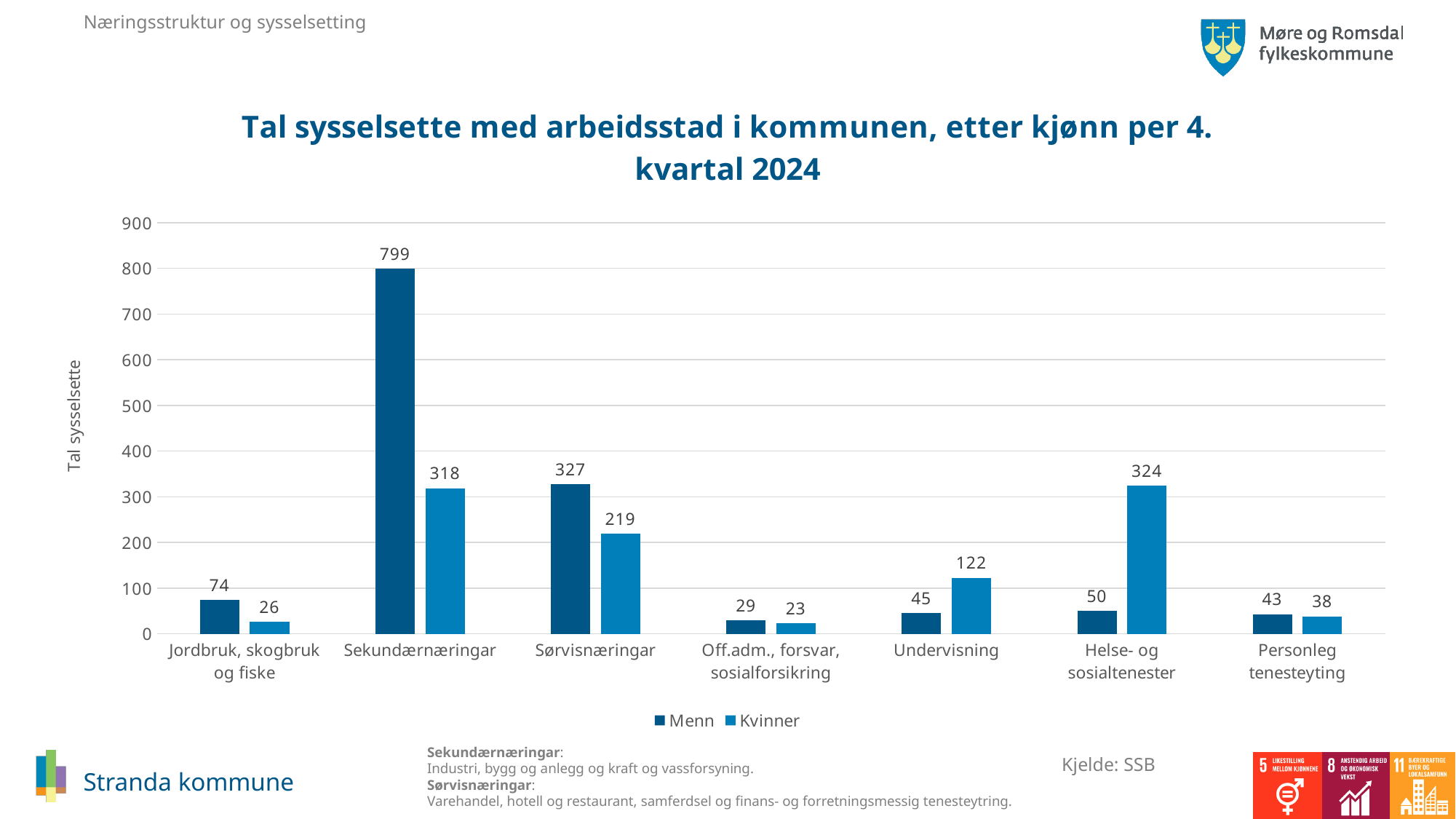
Is the value for Menn in Sørvisnæringar greater or less than 300? greater What kind of chart is shown on the slide? Bar chart Which is larger in Helse- og sosialtenester, Menn or Kvinner? Kvinner What is the value for Menn in Sekundærnæringar? 799 What is the difference between Menn and Kvinner in Sørvisnæringar? 108 How many series does the legend list? 2 What is the difference between Menn and Kvinner in Sekundærnæringar? 481 What is the value for Kvinner in Undervisning? 122 What is the value for Kvinner in Helse- og sosialtenester? 324 Which category has the highest value for Menn? Sekundærnæringar Which category has the lowest value for Kvinner? Off.adm., forsvar, sosialforsikring How many categories are shown on the x axis? 7